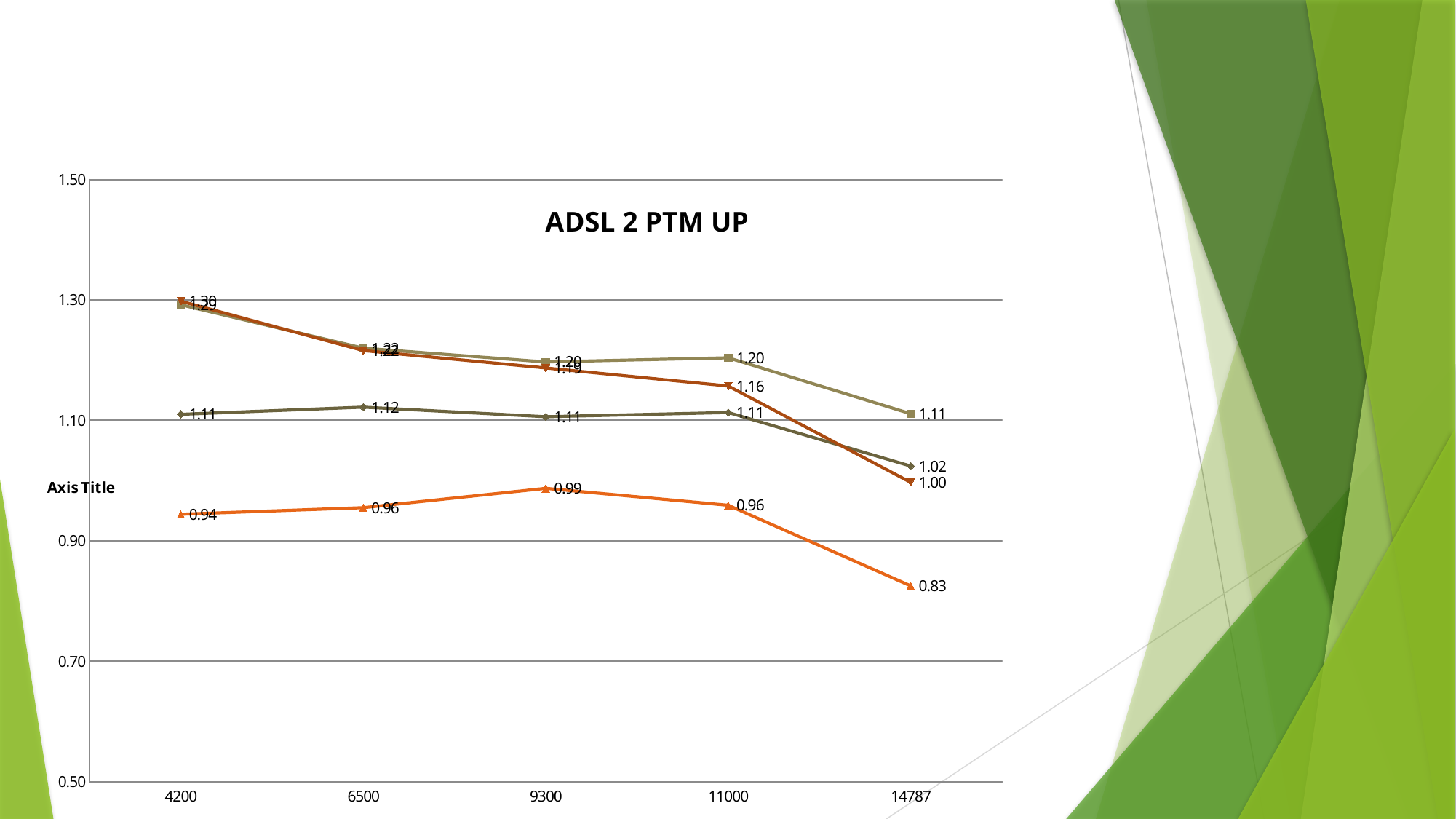
What is the difference between the orange line's value at 9300 and its value at 14787? 0.16 At which x-axis category does the orange line with triangle markers reach its lowest value? 14787 What is the value of the dark red line with inverted-triangle markers at 11000? 1.16 What is the value of the orange line with triangle markers at 9300? 0.99 What kind of chart is shown on the slide? line chart Does the dark red line with inverted-triangle markers rise or fall from 4200 to 14787? fall What is the value of the line with diamond markers at 14787? 1.02 What is the title of the chart? ADSL 2 PTM UP What is the value of the line with square markers at 14787? 1.11 What is the value of the orange line with triangle markers at 14787? 0.83 How many categories are shown on the x axis of the chart? 5 At which x-axis category does the orange line with triangle markers reach its highest value? 9300